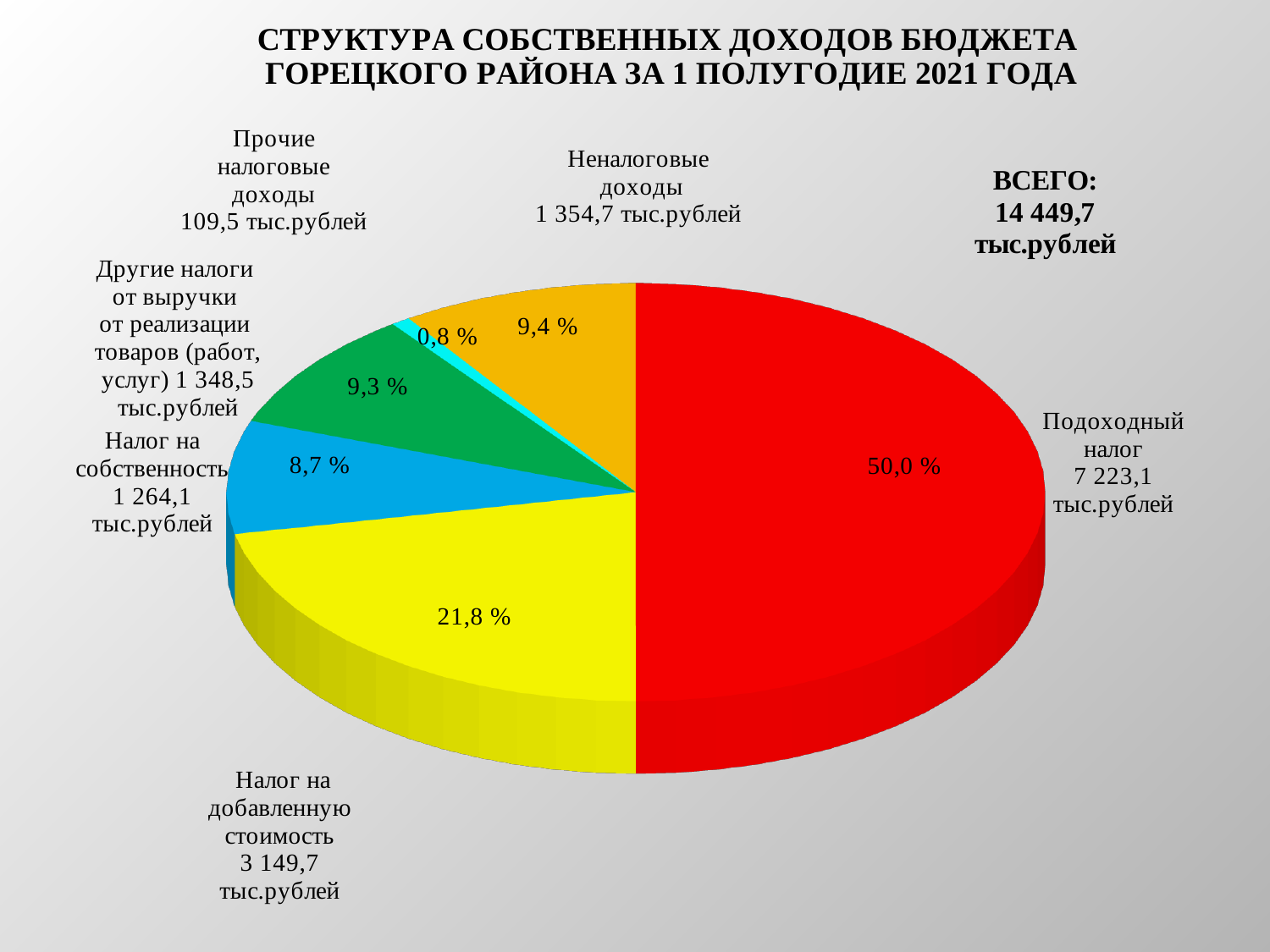
What is the total (ВСЕГО) shown on the slide? 14 449,7 тыс.рублей Which category has the smallest slice of the pie? Прочие налоговые доходы What is the value shown for Налог на добавленную стоимость? 3 149,7 тыс.рублей Which category has the largest slice of the pie? Подоходный налог What share of the pie does Подоходный налог account for? 50,0 % What percentage is shown for Налог на собственность? 8,7 % How many slices does the pie chart have? 6 What kind of chart is shown on the slide? pie chart What is the value shown for Неналоговые доходы? 1 354,7 тыс.рублей Which is larger, the value for Налог на собственность or the value for Неналоговые доходы? Неналоговые доходы What is the difference between the values for Подоходный налог and Налог на добавленную стоимость? 4 073,4 тыс.рублей What colour is the slice for Подоходный налог? red